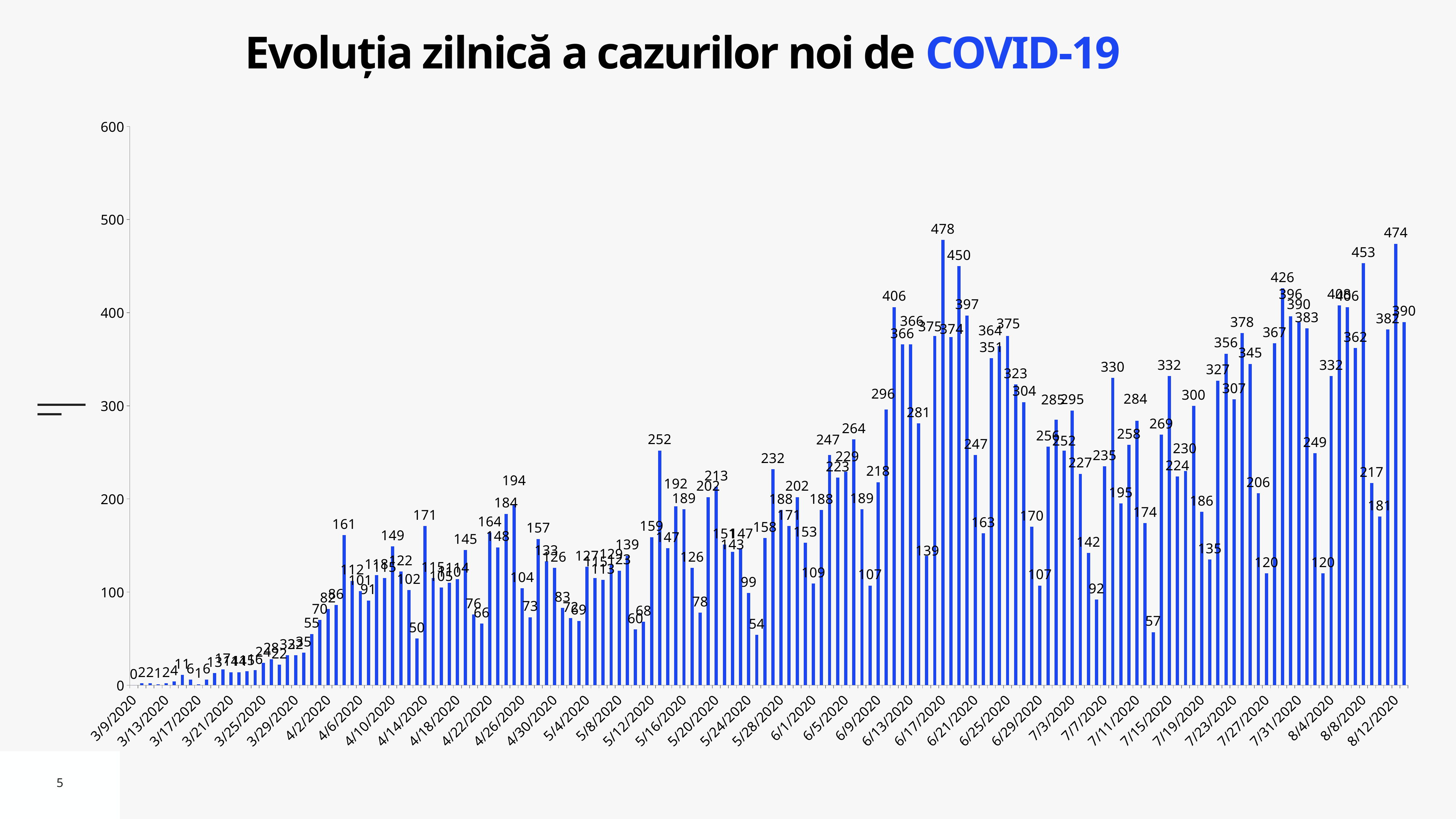
How many data series are plotted in the chart? 1 What is the value for 3/9/2020, the first bar in the chart? 0 Overall, do the daily values rise or fall from March to August along the x axis? rise Is the value for 8/12/2020 greater or less than 300? greater What is the maximum value shown on the y axis? 600 What is the highest daily value shown in the chart? 478 Is the highest bar in the chart greater or less than 500? less What is the lowest daily value shown in the chart? 0 What is the title of the slide? Evoluția zilnică a cazurilor noi de COVID-19 What kind of chart is shown on the slide? bar chart